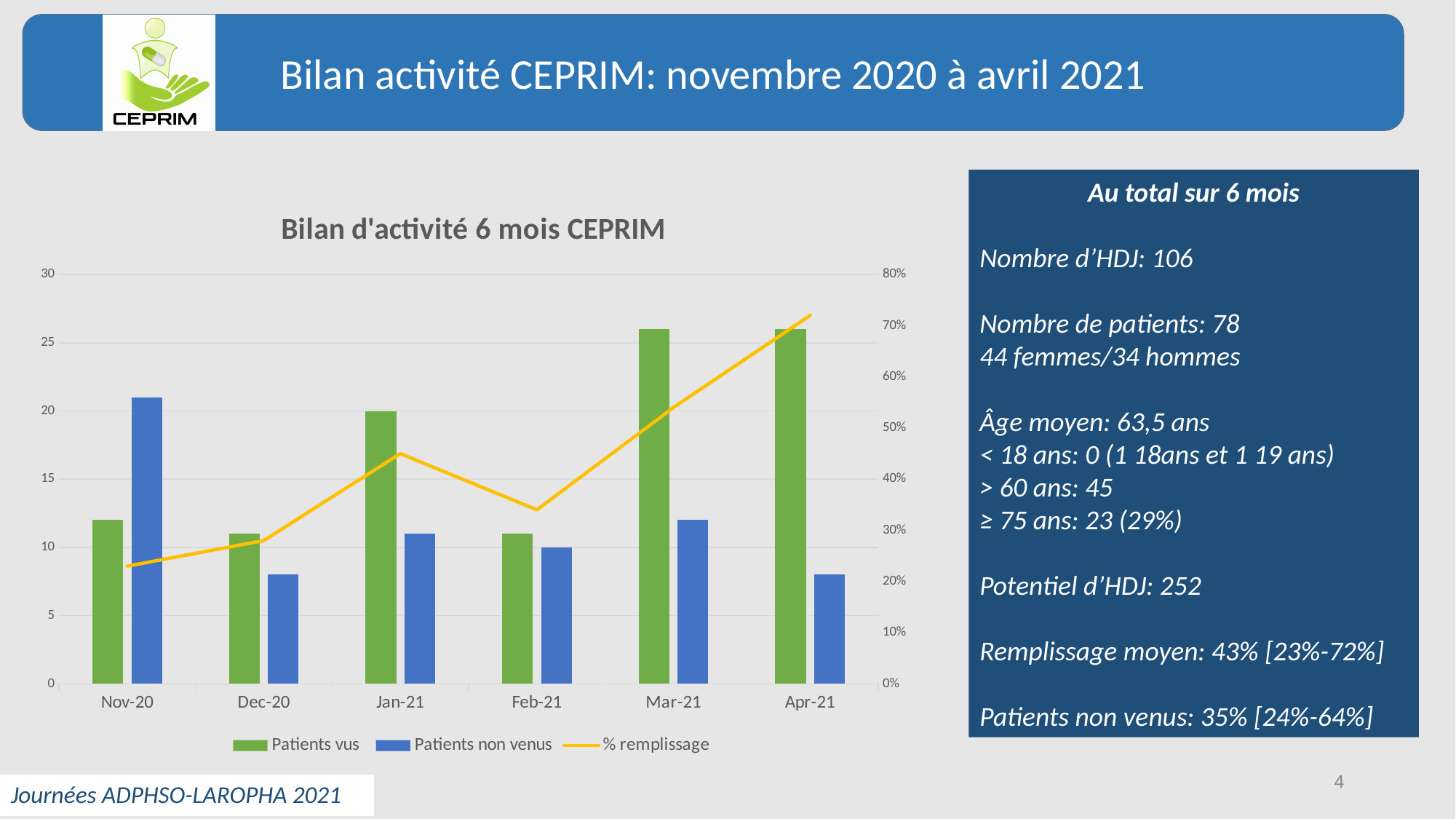
In which month is the % remplissage highest? Apr-21 What is the title of the chart on the slide? Bilan d'activité 6 mois CEPRIM In Mar-21, which is larger: Patients vus or Patients non venus? Patients vus In Nov-20, which is larger: Patients vus or Patients non venus? Patients non venus In which month is the % remplissage lowest? Nov-20 What kind of chart is shown on the slide? Combined bar and line chart Is the % remplissage in Apr-21 greater or less than 60%? greater How many series does the chart legend list? 3 Does the % remplissage rise or fall from Feb-21 to Apr-21? rise How many months are shown on the x axis of the chart? 6 Is the value for Patients vus in Jan-21 greater or less than 15? greater In which month is the value for Patients non venus highest? Nov-20